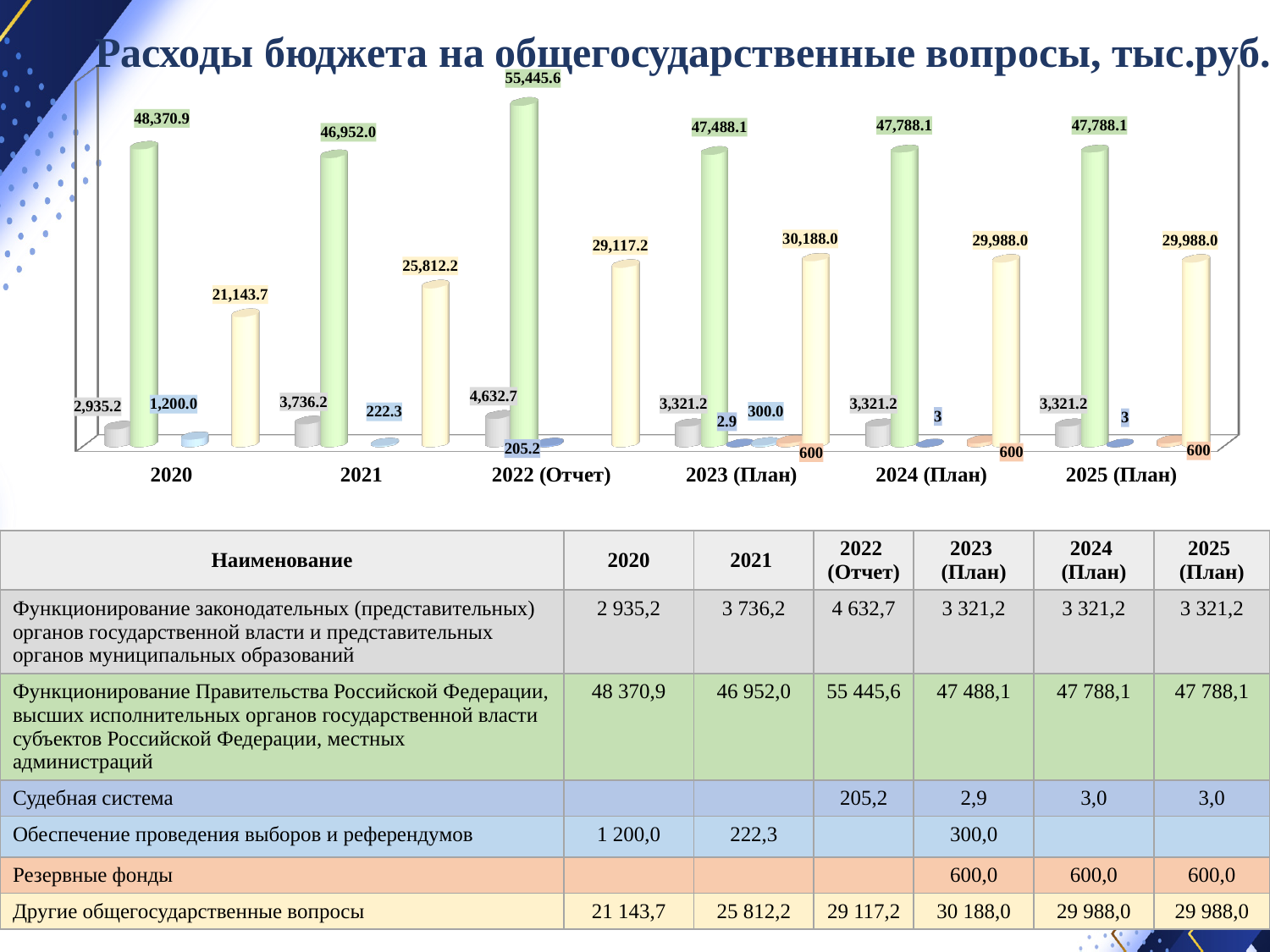
What is the value for Другие общегосударственные вопросы in 2021? 25,812.2 In which year does the green series (Функционирование Правительства Российской Федерации) reach its highest value? 2022 (Отчет) Which is larger: the value for Другие общегосударственные вопросы in 2023 (План) or in 2024 (План)? 2023 (План) How many year categories are shown on the x axis of the chart? 6 What is the difference between the values for Функционирование законодательных органов in 2022 (Отчет) and 2021? 896.5 In which year is the value for Другие общегосударственные вопросы the lowest? 2020 What is the title of the chart? Расходы бюджета на общегосударственные вопросы, тыс.руб. Does the value for Функционирование законодательных органов rise or fall from 2020 to 2022 (Отчет)? Rise What kind of chart is shown on the slide? Bar chart What is the value for Резервные фонды in 2023 (План)? 600 What is the value of the tallest (green) bar for 2022 (Отчет), i.e. Функционирование Правительства Российской Федерации? 55,445.6 What is the difference between the green series value in 2022 (Отчет) and in 2020? 7,074.7